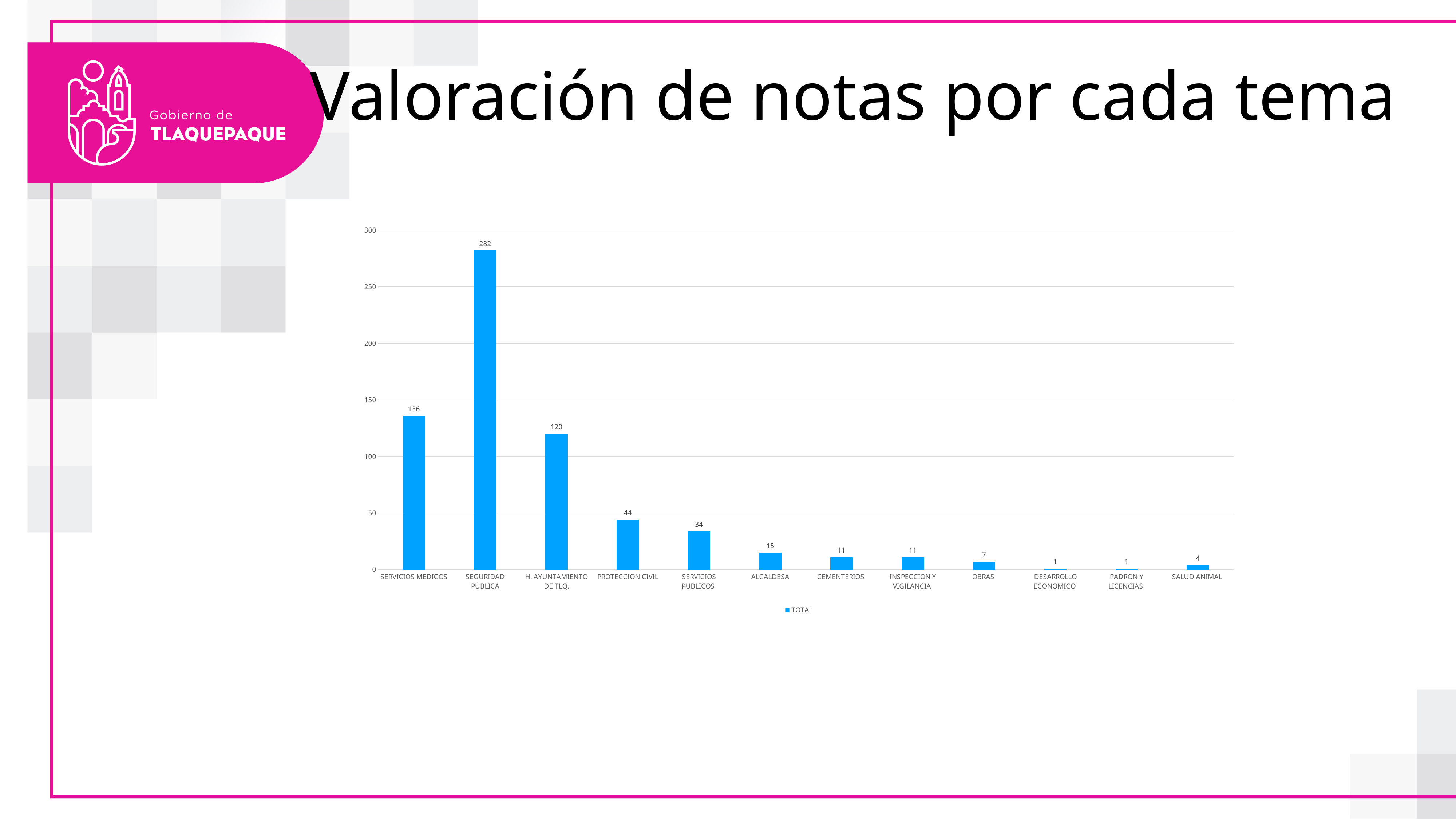
What is the value for SALUD ANIMAL? 4 Is the value for SERVICIOS MEDICOS greater or less than 100? greater Which category has the highest value? SEGURIDAD PÚBLICA What is the value for PROTECCION CIVIL? 44 What kind of chart is shown on the slide? bar chart How many categories are shown on the x axis? 12 Which is larger, the value for ALCALDESA or the value for OBRAS? ALCALDESA What is the difference between the values for SEGURIDAD PÚBLICA and SERVICIOS MEDICOS? 146 How many series does the legend list? 1 What is the name of the series shown in the legend? TOTAL What is the value for SEGURIDAD PÚBLICA? 282 What is the difference between the values for SERVICIOS MEDICOS and H. AYUNTAMIENTO DE TLQ.? 16